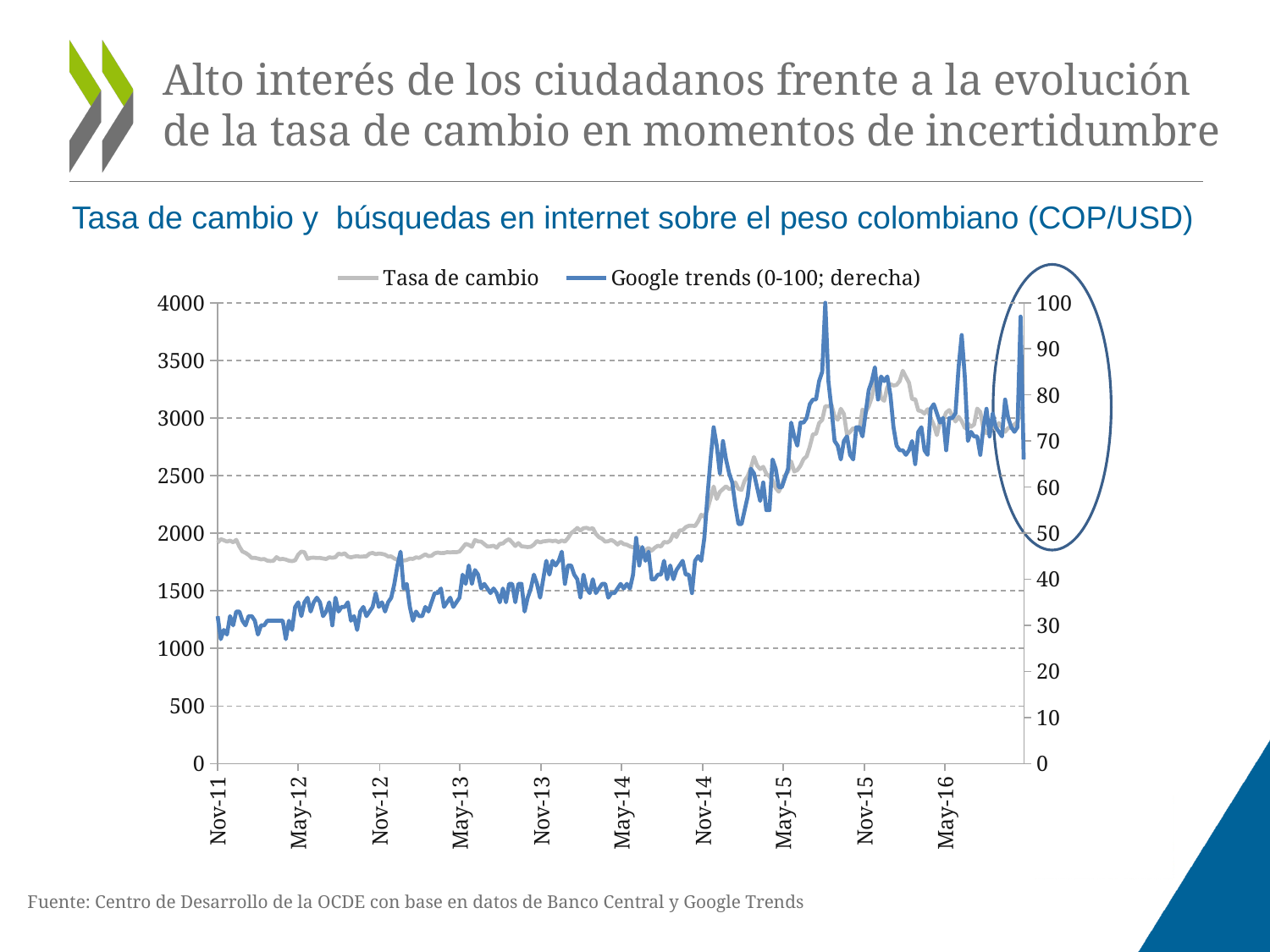
How many series does the legend list? 2 Which series is plotted against the right-hand axis according to the legend? Google trends (0-100; derecha) What kind of chart is shown on the slide? Line chart Does the Tasa de cambio line overall rise or fall from Nov-11 to 2016? Rise Is the value of Tasa de cambio at May-15 greater or less than 2000? greater What colour is the line for Tasa de cambio? Grey How many date labels are shown on the x axis? 10 Which is larger for Tasa de cambio: the value at May-12 or the value at May-15? May-15 Is the value of Tasa de cambio at May-12 greater or less than 2000? less Is the value of Google trends at Nov-11 greater or less than 40? less What is the maximum value shown on the left-hand axis? 4000